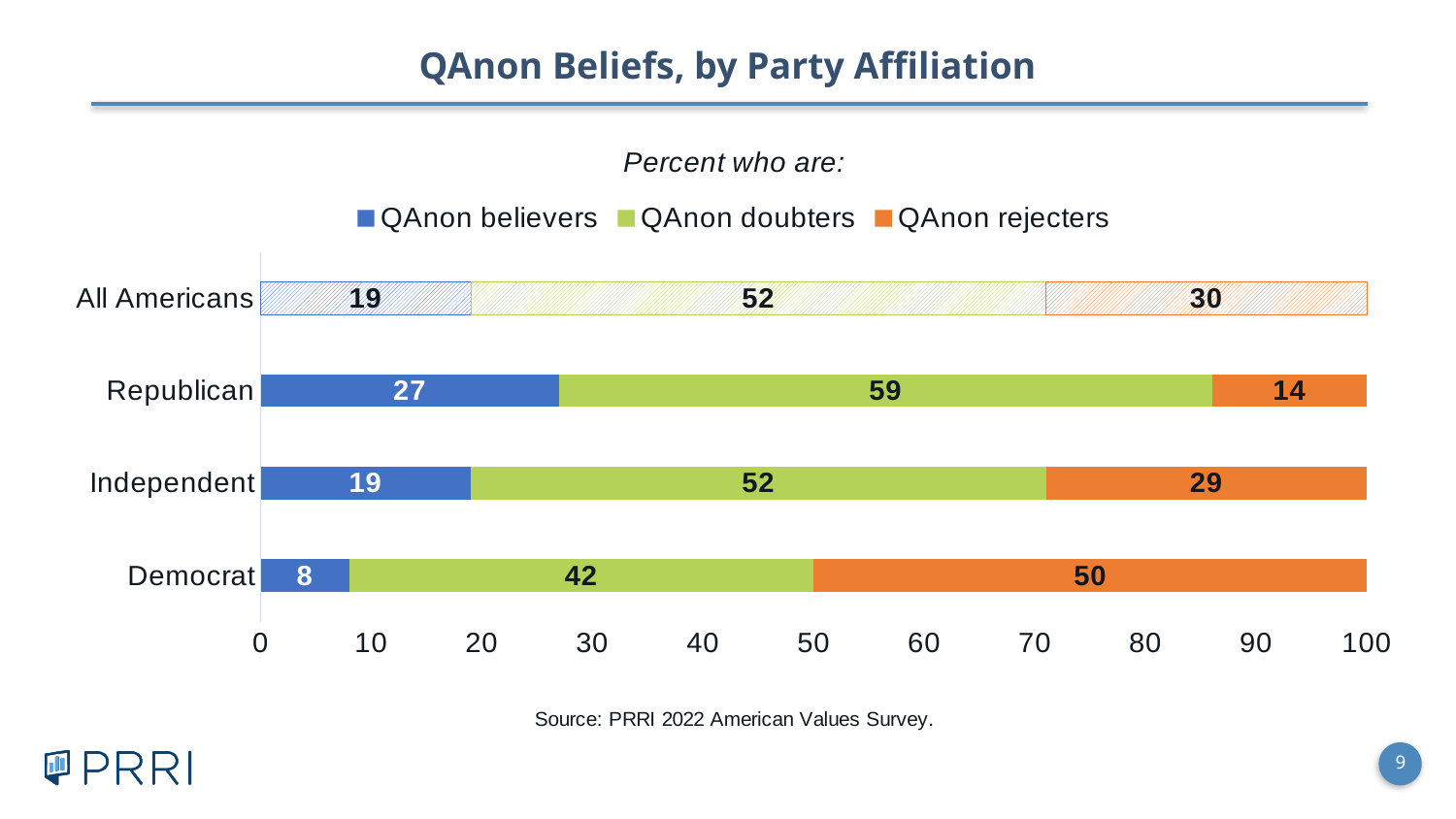
Which group has the lowest percentage of QAnon rejecters? Republican What is the difference between the percentage of Democrats and Republicans who are QAnon believers? 19 What percentage of Democrats are QAnon rejecters? 50 What is the total of the stacked bar for Democrat? 100 Which is larger: the percentage of Independents who are QAnon rejecters or the percentage of Republicans who are QAnon rejecters? Independent How many series does the legend list? 3 What percentage of Republicans are QAnon believers? 27 Which party affiliation group has the highest percentage of QAnon believers? Republican How many party affiliation groups are shown on the chart? 3 What is the title of the chart? Percent who are: What percentage of Independents are QAnon doubters? 52 What kind of chart is shown on the slide? Stacked bar chart